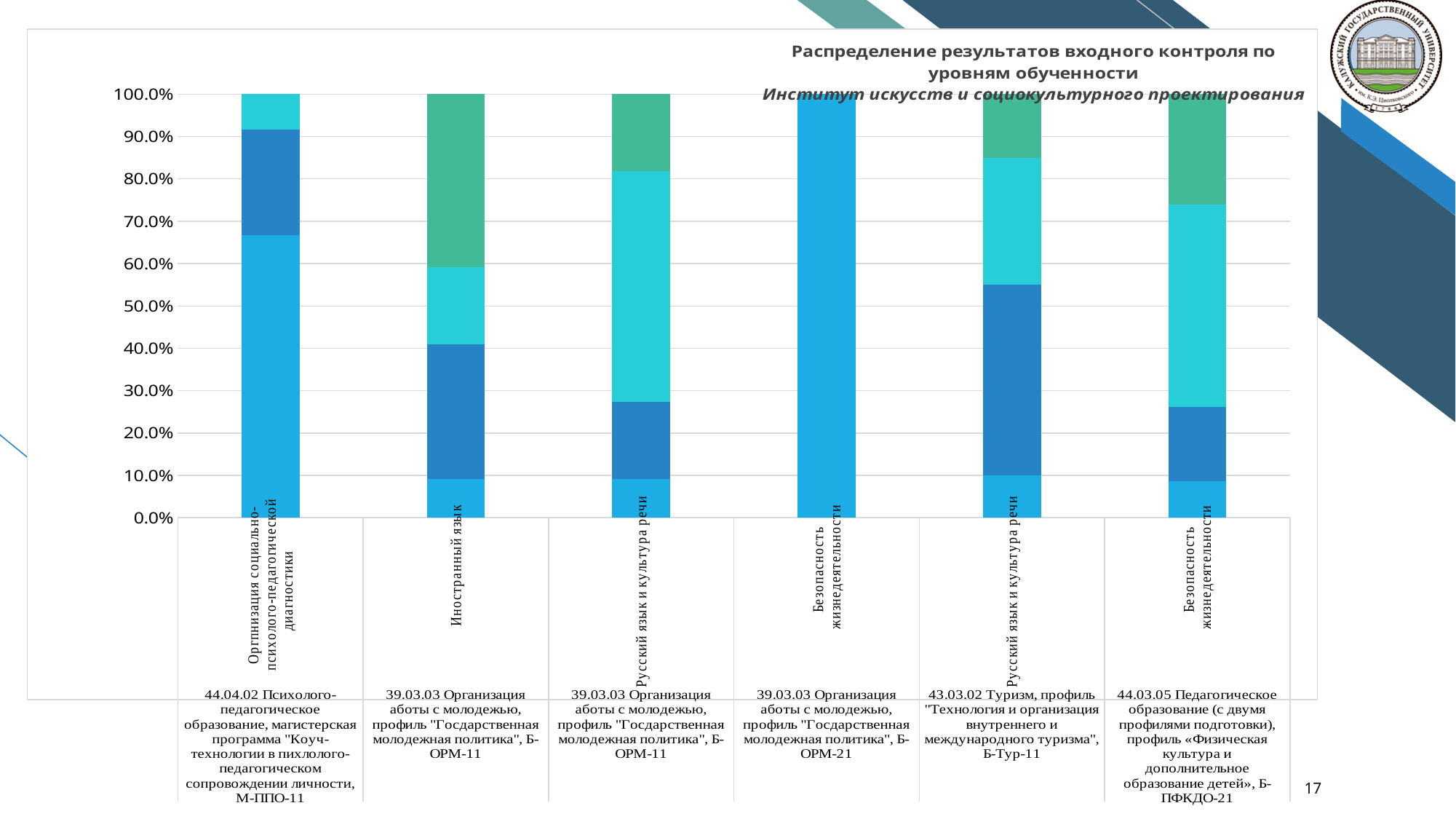
Is the top of the dark blue segment in the bar for 'Русский язык и культура речи' (Б-Тур-11) greater or less than 50%? greater Is the top of the dark blue segment in the bar for 'Безопасность жизнедеятельности' (Б-ПФКДО-21) greater or less than 30%? less Which has the larger bottom (light blue) segment: the bar for 'Организация социально-психолого-педагогической диагностики' (М-ППО-11) or the bar for 'Иностранный язык' (Б-ОРМ-11)? Организация социально-психолого-педагогической диагностики (М-ППО-11) Which institute is named in the chart's subtitle? Институт искусств и социокультурного проектирования Which bar consists entirely of a single (light blue) segment reaching 100%? Безопасность жизнедеятельности (Б-ОРМ-21) What is the highest value shown on the vertical axis? 100.0% How many bars (categories) are plotted in the chart? 6 Is the bottom (light blue) segment of the bar for 'Иностранный язык' (Б-ОРМ-11) greater or less than 20%? less What kind of chart is shown on the slide? Stacked bar chart What is the title of the chart? Распределение результатов входного контроля по уровням обученности